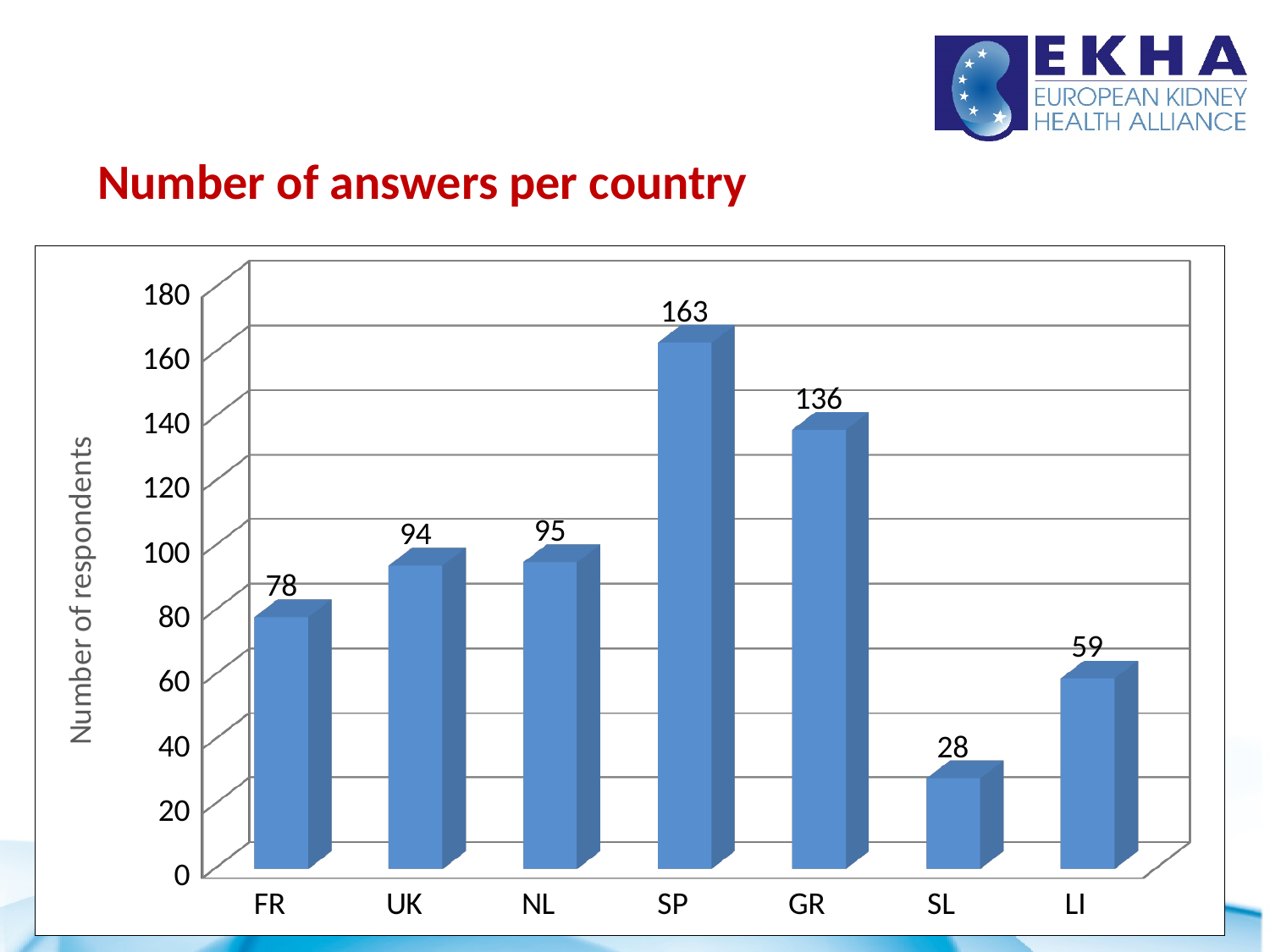
Is the value for GR greater or less than 120? greater What is the difference in number of respondents between FR and LI? 19 What kind of chart is shown on the slide? Bar chart Which country has the highest number of respondents? SP Which has more respondents, FR or LI? FR What is the label of the vertical axis? Number of respondents Which country has the lowest number of respondents? SL What is the number of respondents for SP? 163 What is the difference in number of respondents between SP and GR? 27 How many countries are shown on the x axis? 7 What is the number of respondents for GR? 136 What is the number of respondents for SL? 28